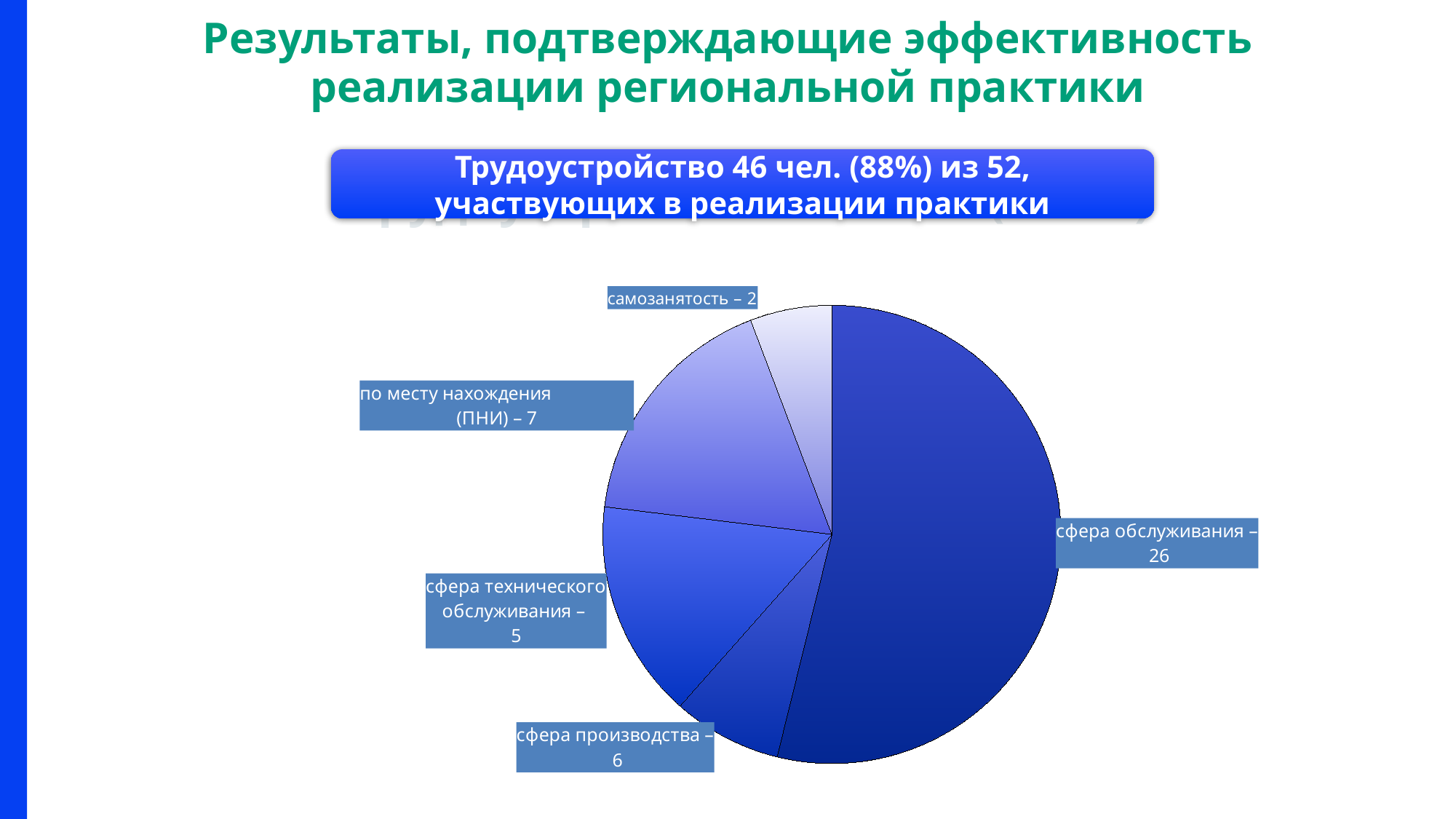
What is the value for "по месту нахождения (ПНИ)"? 7 What kind of chart is shown on the slide? pie chart What is the total of all the slices in the pie chart? 46 Which is larger, the value for "сфера производства" or the value for "сфера технического обслуживания"? сфера производства What is the value for "сфера технического обслуживания"? 5 What is the value for "сфера производства"? 6 What is the difference between the values for "сфера обслуживания" and "по месту нахождения (ПНИ)"? 19 What is the value for "самозанятость"? 2 Which category has the largest slice of the pie? сфера обслуживания How many slices does the pie chart have? 5 Which category has the smallest slice of the pie? самозанятость What is the value for "сфера обслуживания"? 26